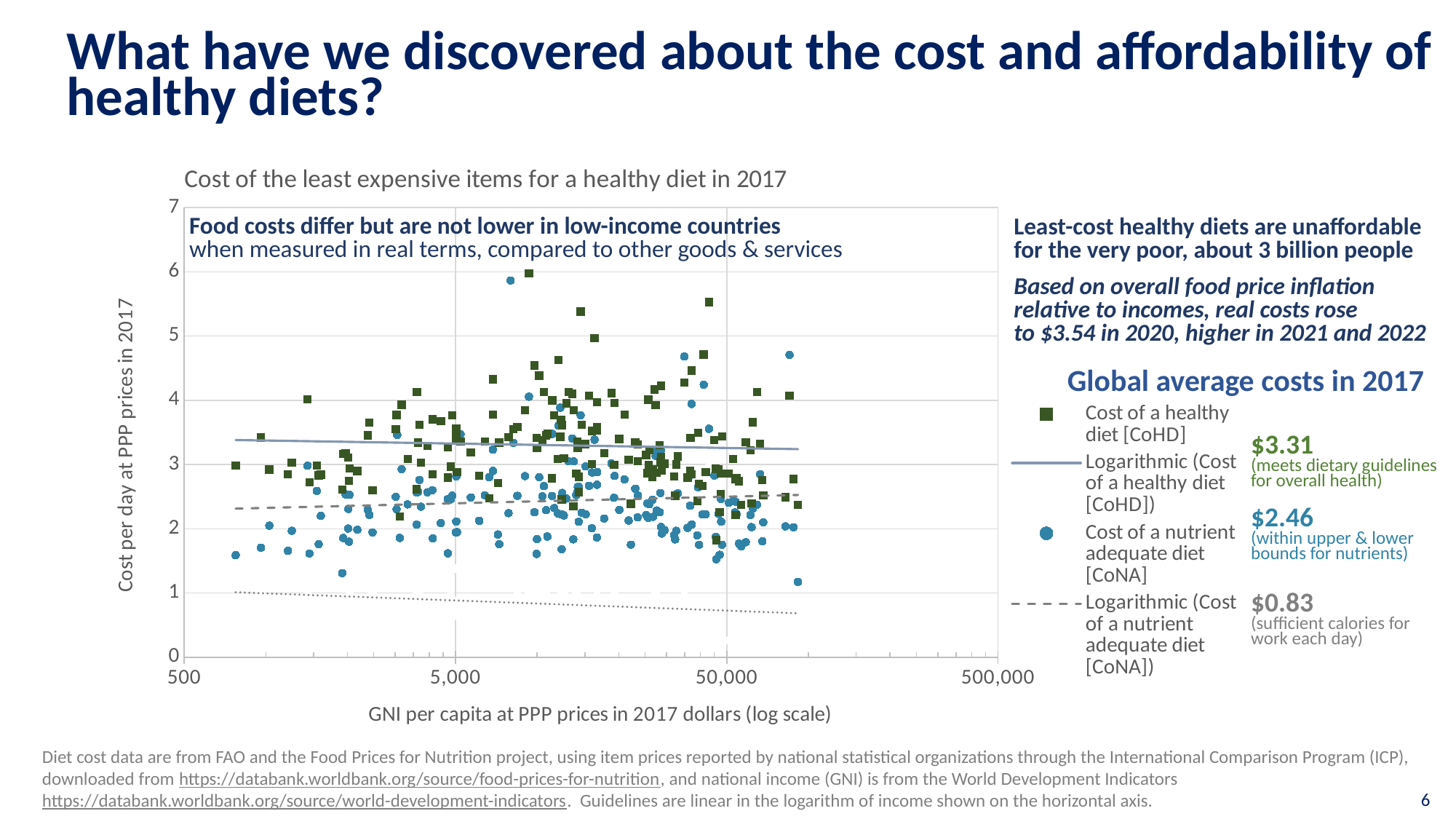
What is the global average cost of a nutrient adequate diet [CoNA] in 2017 shown on the slide? $2.46 What is the title of the chart? Cost of the least expensive items for a healthy diet in 2017 What is the label of the horizontal axis of the chart? GNI per capita at PPP prices in 2017 dollars (log scale) What is the global average cost in 2017 for sufficient calories for work each day? $0.83 What kind of chart is shown on the slide? scatter chart Is the highest plotted cost of a healthy diet [CoHD] point greater or less than 5? greater What is the difference between the global average cost of a healthy diet ($3.31) and of a nutrient adequate diet ($2.46)? $0.85 What is the highest value shown on the vertical axis of the chart? 7 How many entries does the chart legend list? 4 What is the global average cost of a healthy diet [CoHD] in 2017 shown on the slide? $3.31 Does the solid logarithmic trend line for the cost of a healthy diet [CoHD] rise or fall as GNI per capita increases? fall Which global average cost in 2017 is higher: the cost of a healthy diet [CoHD] or the cost of a nutrient adequate diet [CoNA]? Cost of a healthy diet [CoHD]